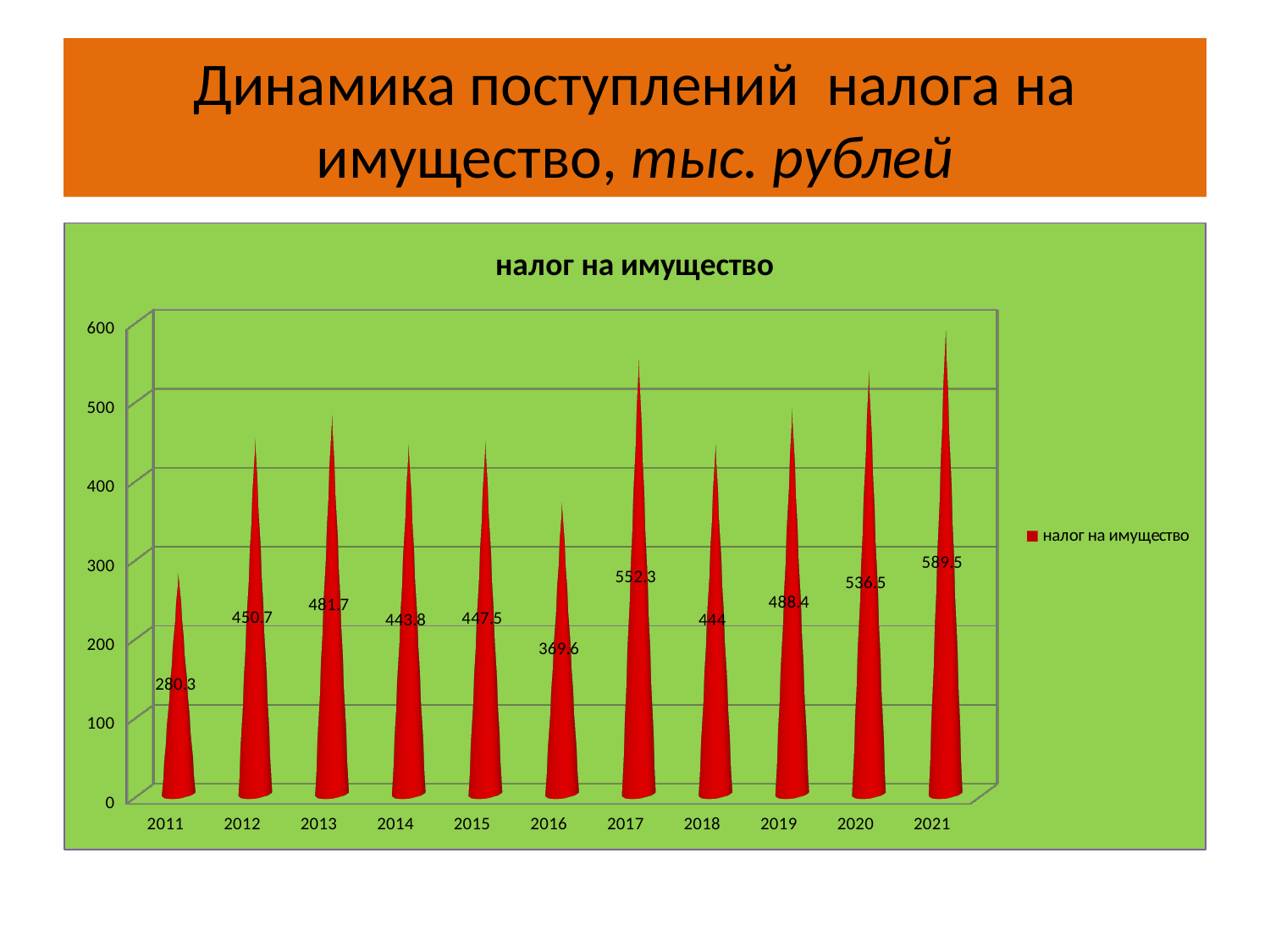
What is the value for 2011? 280.3 Which year has the lowest value? 2011 How many series does the legend list? 1 Which year has the highest value? 2021 What is the value for 2021? 589.5 What is the difference between the values for 2021 and 2011? 309.2 What is the title of the chart inside the plot area? налог на имущество What is the value for 2017? 552.3 Which is larger, the value for 2020 or the value for 2019? 2020 How many years are shown on the x axis? 11 What is the value for 2016? 369.6 What kind of chart is this? bar chart